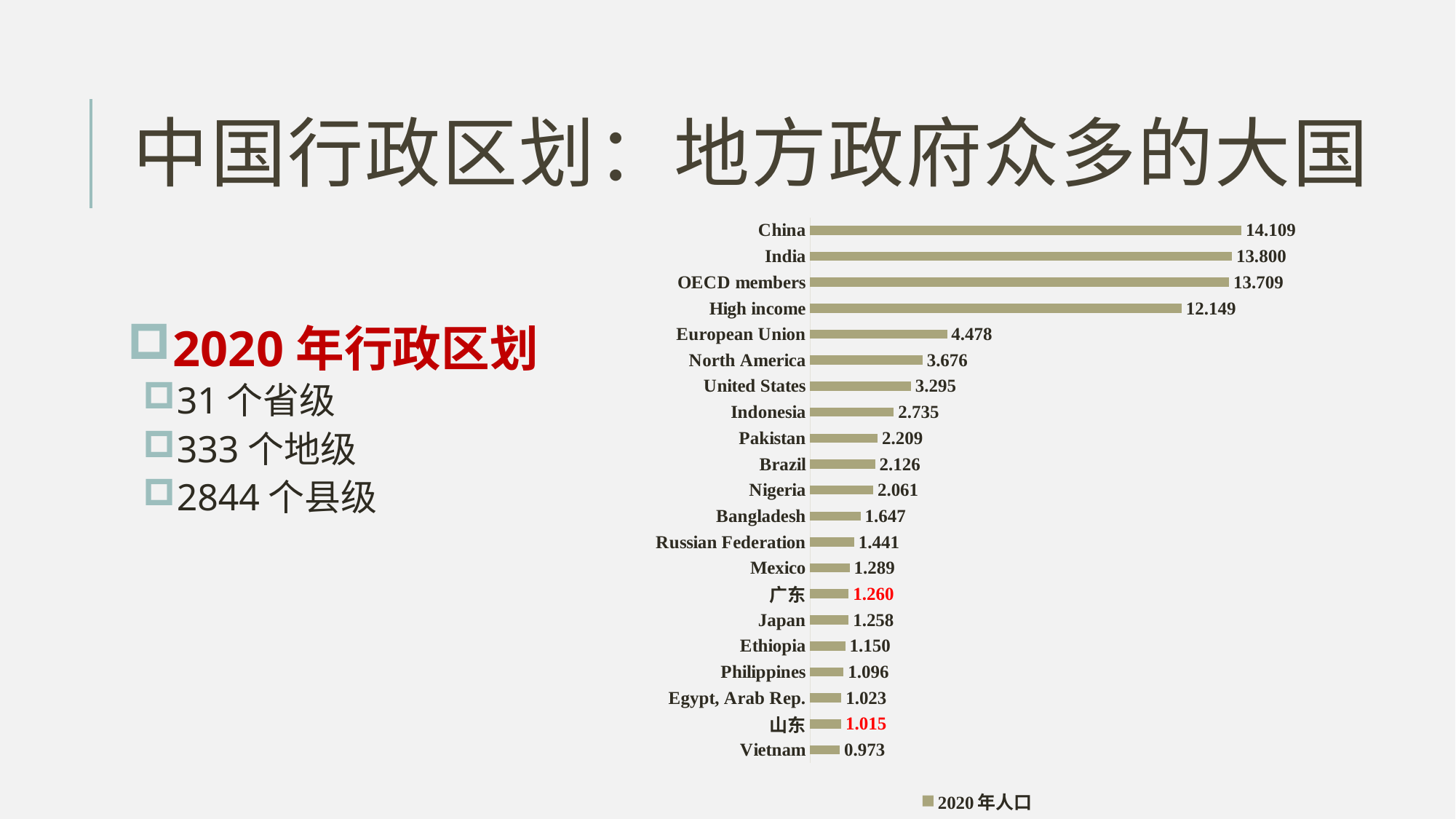
Which category has the lowest value in the chart? Vietnam What is the value for Russian Federation in the chart? 1.441 Which is larger, the value for European Union or the value for North America? European Union Which category has the highest value in the chart? China How many categories are shown in the chart? 21 What is the value for China in the chart? 14.109 What is the difference between the values for United States and Indonesia? 0.560 What is the value for 广东 in the chart? 1.260 How many series does the legend list? 1 What kind of chart is shown on the slide? Bar chart What is the value for Vietnam in the chart? 0.973 What is the difference between the values for China and India? 0.309